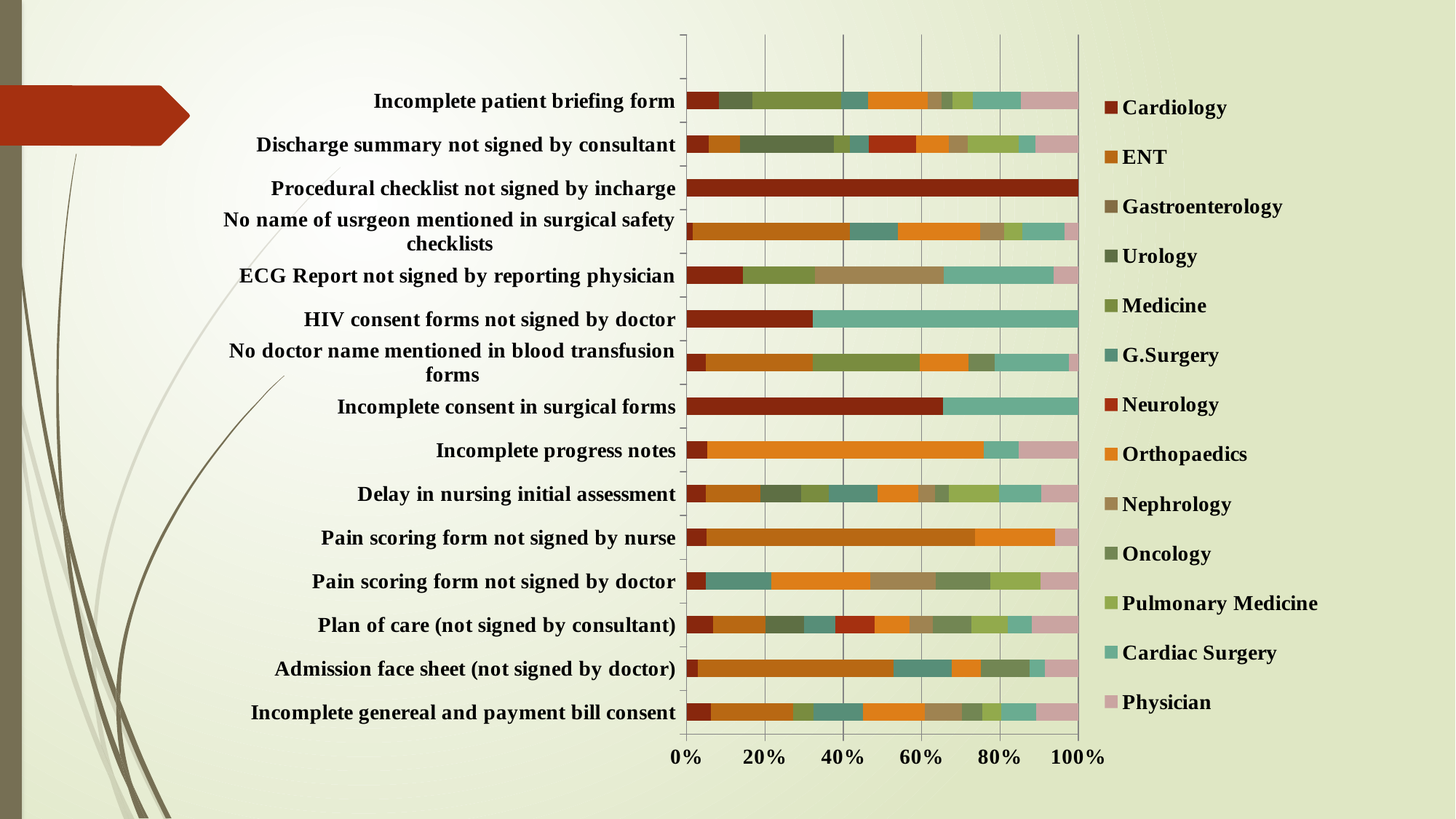
Which series is listed last in the legend? Physician Which single series makes up the entire bar for 'Procedural checklist not signed by incharge'? Cardiology Is the ENT value for 'Admission face sheet (not signed by doctor)' greater or less than 40%? greater For 'HIV consent forms not signed by doctor', which is larger: Cardiology or Cardiac Surgery? Cardiac Surgery Is the Cardiology value for 'Incomplete consent in surgical forms' greater or less than 40%? greater How many series does the legend list? 13 How many categories are plotted on the vertical axis? 15 Is the Cardiology value for 'Procedural checklist not signed by incharge' greater or less than 80%? greater What kind of chart is shown on the slide? Stacked bar chart For 'Incomplete consent in surgical forms', which is larger: Cardiology or Cardiac Surgery? Cardiology